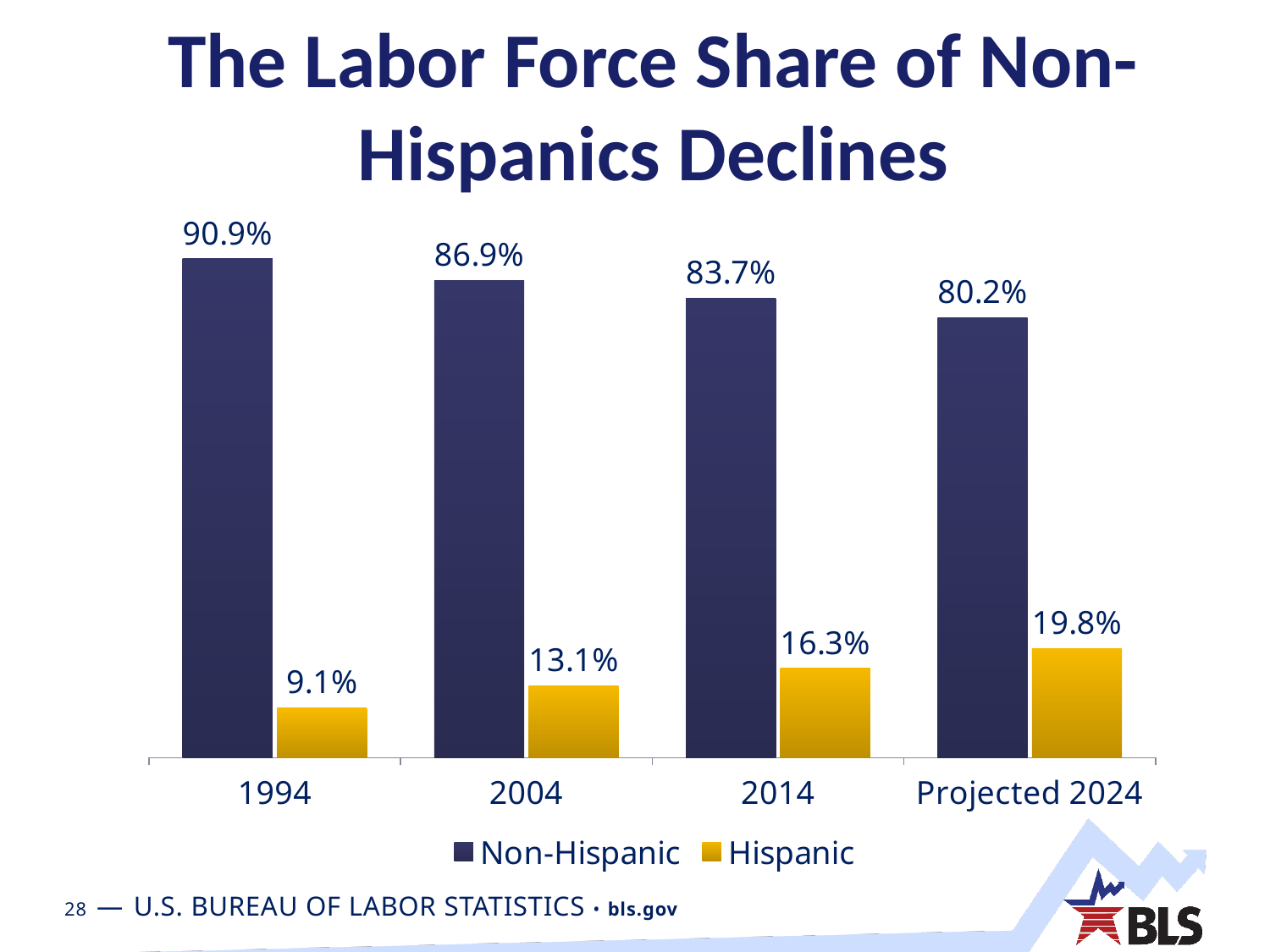
In which year is the Non-Hispanic share highest? 1994 What is the difference between the Non-Hispanic share in 1994 and the projected Non-Hispanic share in 2024? 10.7 percentage points How many series does the legend list? 2 How many time periods are shown on the x axis? 4 What is the Hispanic labor force share in 2014? 16.3% What is the Non-Hispanic labor force share in 1994? 90.9% Which is larger, the Hispanic share in 2014 or the Hispanic share in 2004? 2014 In which year is the Hispanic share lowest? 1994 What is the Non-Hispanic labor force share in 2004? 86.9% What kind of chart is shown on the slide? Bar chart What is the difference between the Hispanic share in 2004 and in 2014? 3.2 percentage points What is the projected Hispanic labor force share for 2024? 19.8%